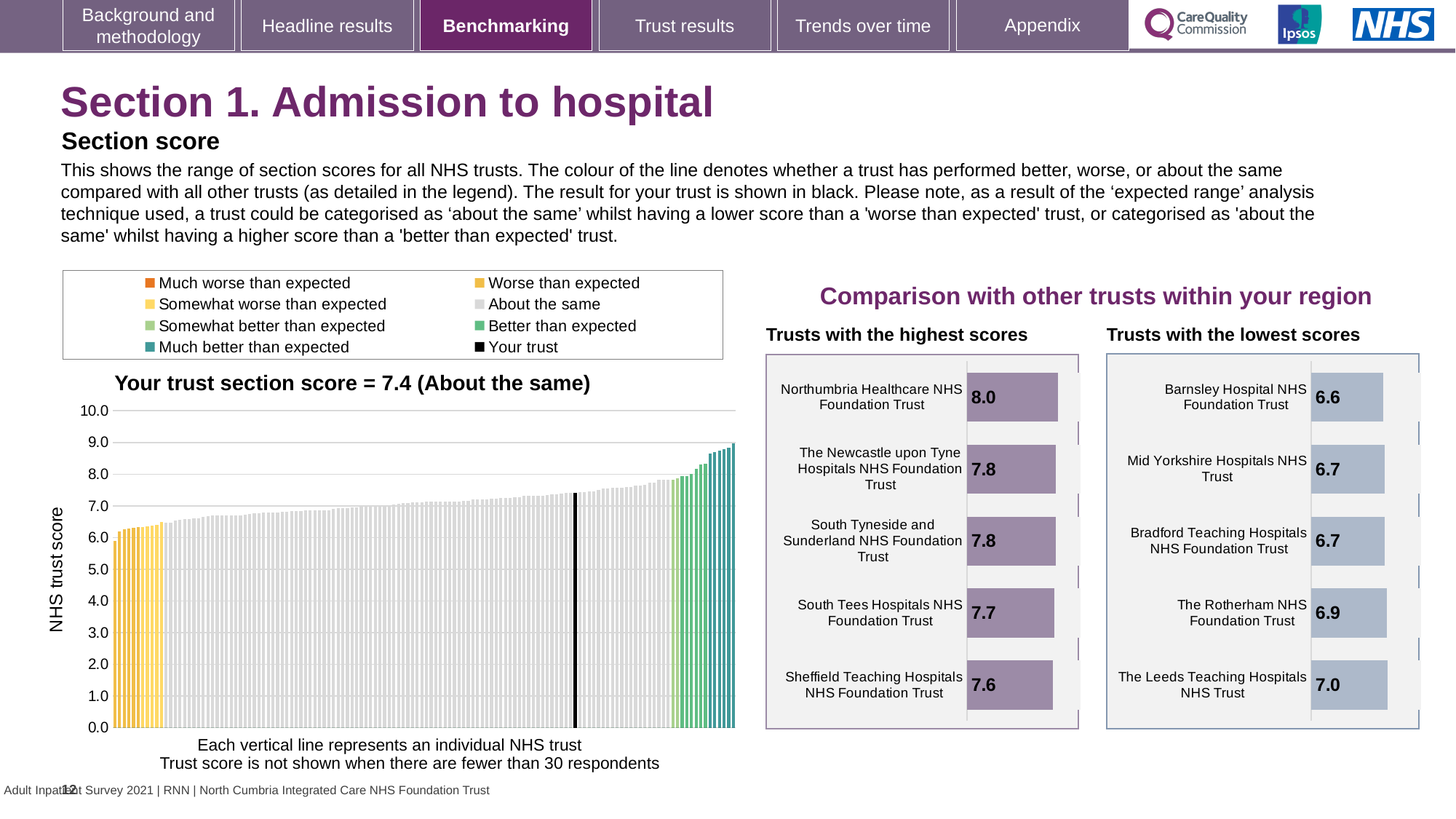
In the 'Trusts with the highest scores' chart, which trust has the lowest score? Sheffield Teaching Hospitals NHS Foundation Trust In the 'Your trust section score' chart, what category is your trust placed in, as stated in the chart title? About the same In the 'Trusts with the lowest scores' chart, what is the score for Barnsley Hospital NHS Foundation Trust? 6.6 How many entries does the legend above the 'Your trust section score' chart list? 8 How many trusts are shown in the 'Trusts with the highest scores' chart? 5 In the 'Trusts with the highest scores' chart, what is the difference between the scores of Northumbria Healthcare NHS Foundation Trust and Sheffield Teaching Hospitals NHS Foundation Trust? 0.4 In the 'Trusts with the highest scores' chart, what is the score for Northumbria Healthcare NHS Foundation Trust? 8.0 In the 'Your trust section score' chart, what is the section score for your trust? 7.4 In the 'Your trust section score' chart, do the trust scores rise or fall from left to right along the x axis? rise In the 'Trusts with the lowest scores' chart, which trust has the highest score? The Leeds Teaching Hospitals NHS Trust What kind of chart is the 'Your trust section score' chart? bar chart In the 'Trusts with the lowest scores' chart, which has the larger score: The Rotherham NHS Foundation Trust or Mid Yorkshire Hospitals NHS Trust? The Rotherham NHS Foundation Trust